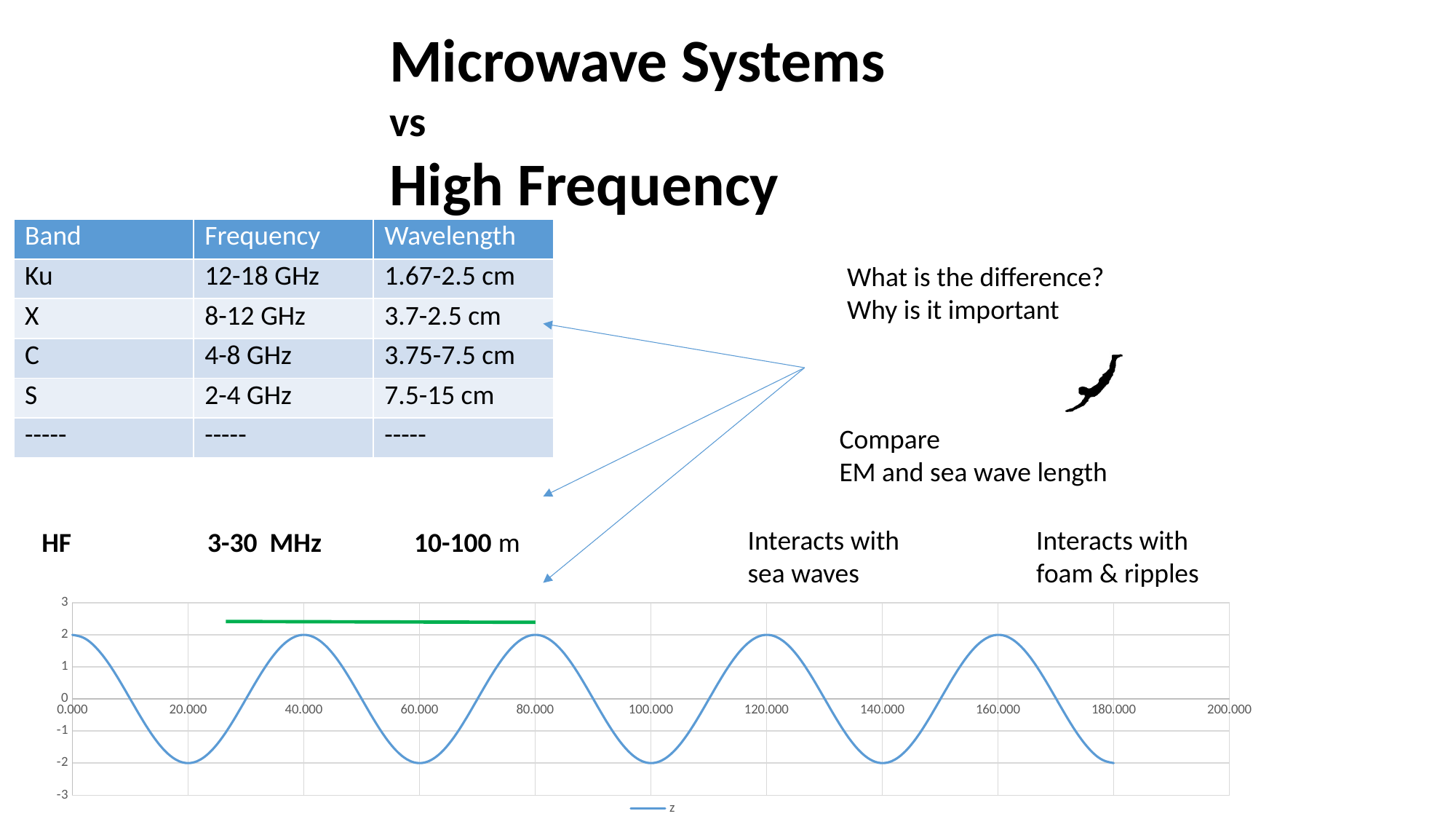
What is the highest value the line reaches? 2 What is the difference between the highest and lowest values of the line? 4 What is the lowest value the line reaches? -2 What is the name of the series shown in the chart legend? z Is the value of the line at x = 140.000 greater or less than -1? less Is the value of the line at x = 80.000 greater or less than 1? greater Between x = 0.000 and x = 20.000, does the line rise or fall? fall Which is larger, the value of the line at x = 120.000 or at x = 60.000? 120.000 What kind of chart is shown at the bottom of the slide? line chart What is the value of the line at x = 100.000? -2 What is the value of the line at x = 40.000? 2 How many series does the chart legend list? 1